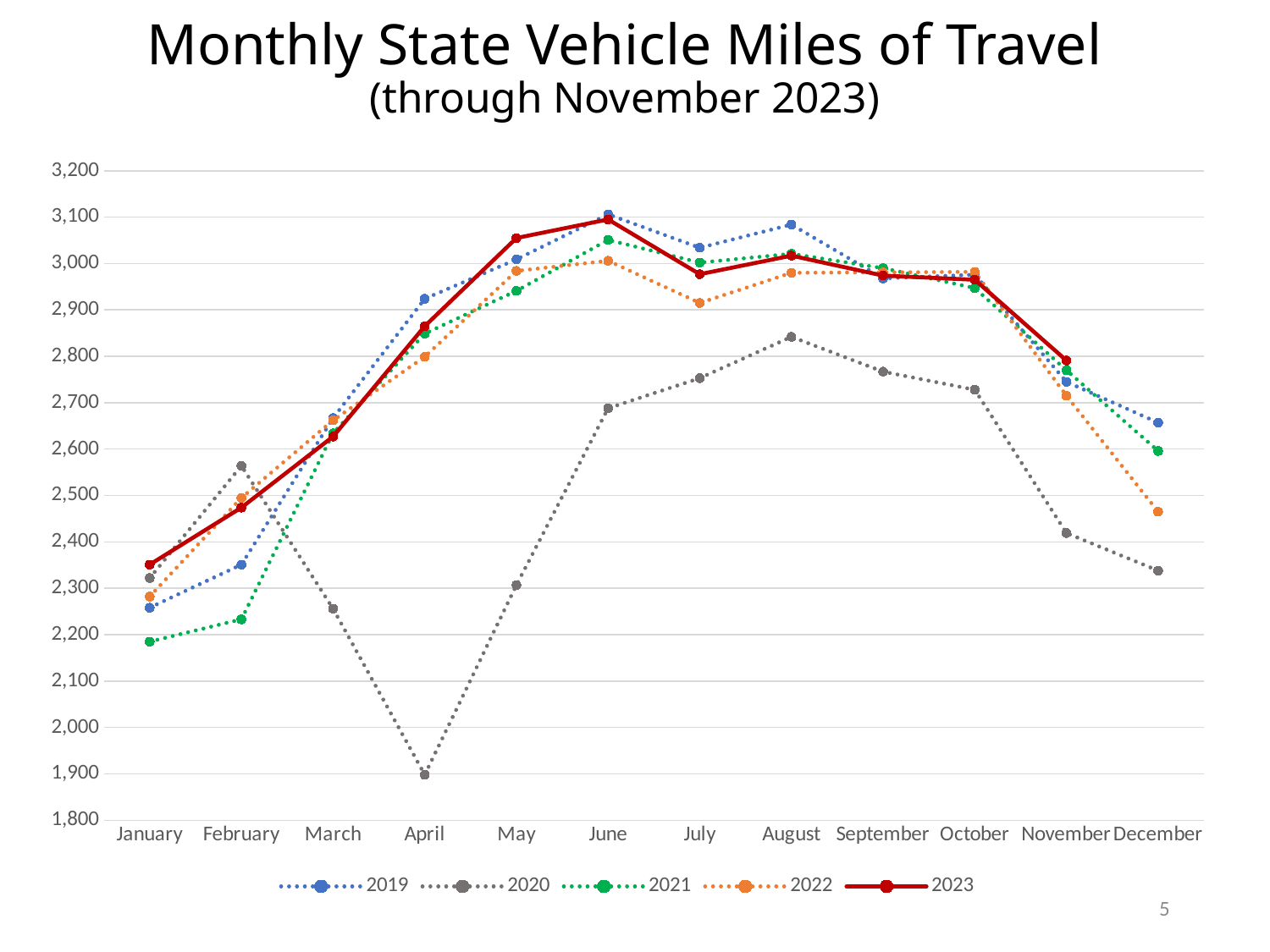
How many months are shown along the x axis? 12 In July, which is larger: the value for 2020 or the value for 2023? 2023 Does the 2023 series rise or fall from January to June? rise Which year has the highest value in August? 2019 What kind of chart is shown on the slide? line chart How many series does the legend list? 5 In December, which is larger: the value for 2019 or the value for 2022? 2019 In which month is the 2020 series at its lowest? April In which month is the 2023 series at its highest? June Is the value for 2020 in April greater or less than 2,000? less Is the value for 2019 in June greater or less than 3,000? greater Is the value for 2021 in January greater or less than 2,300? less